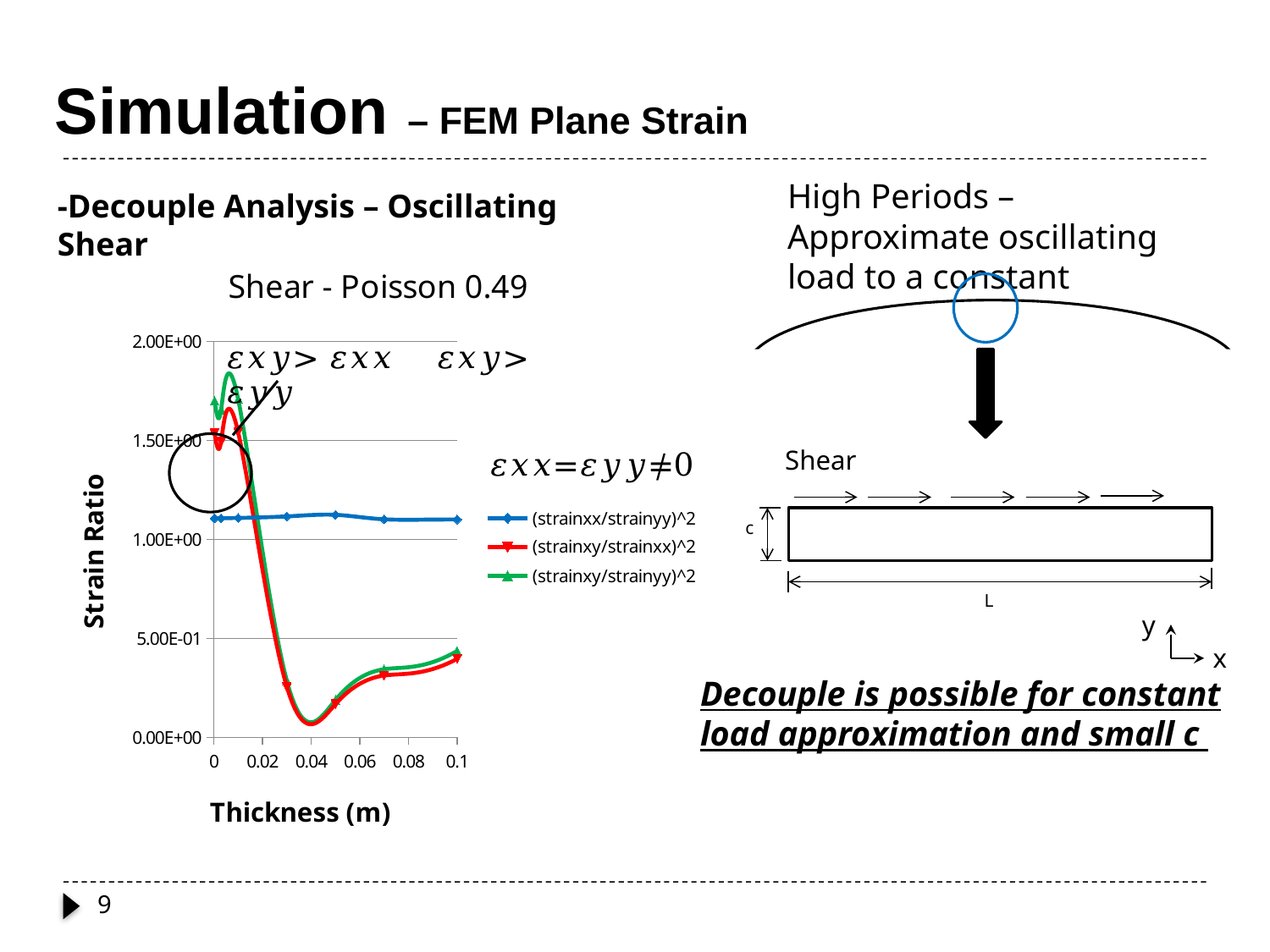
Is the value of the (strainxy/strainxx)^2 series at thickness 0.04 greater or less than 5.00E-01? less Which series has the highest value at thickness 0? (strainxy/strainyy)^2 How many series does the legend of the chart list? 3 What is the highest tick value shown on the y axis of the chart? 2.00E+00 Is the value of the (strainxy/strainxx)^2 series at thickness 0.1 greater or less than 5.00E-01? less Is the value of the (strainxy/strainyy)^2 series at thickness 0 greater or less than 1.50E+00? greater At thickness 0.04, which series has the larger value: (strainxx/strainyy)^2 or (strainxy/strainxx)^2? (strainxx/strainyy)^2 What is the label of the x axis of the chart? Thickness (m) Does the (strainxy/strainxx)^2 series rise or fall between thickness 0.01 and 0.04? fall What kind of chart is shown on the slide? line chart What is the title of the chart? Shear - Poisson 0.49